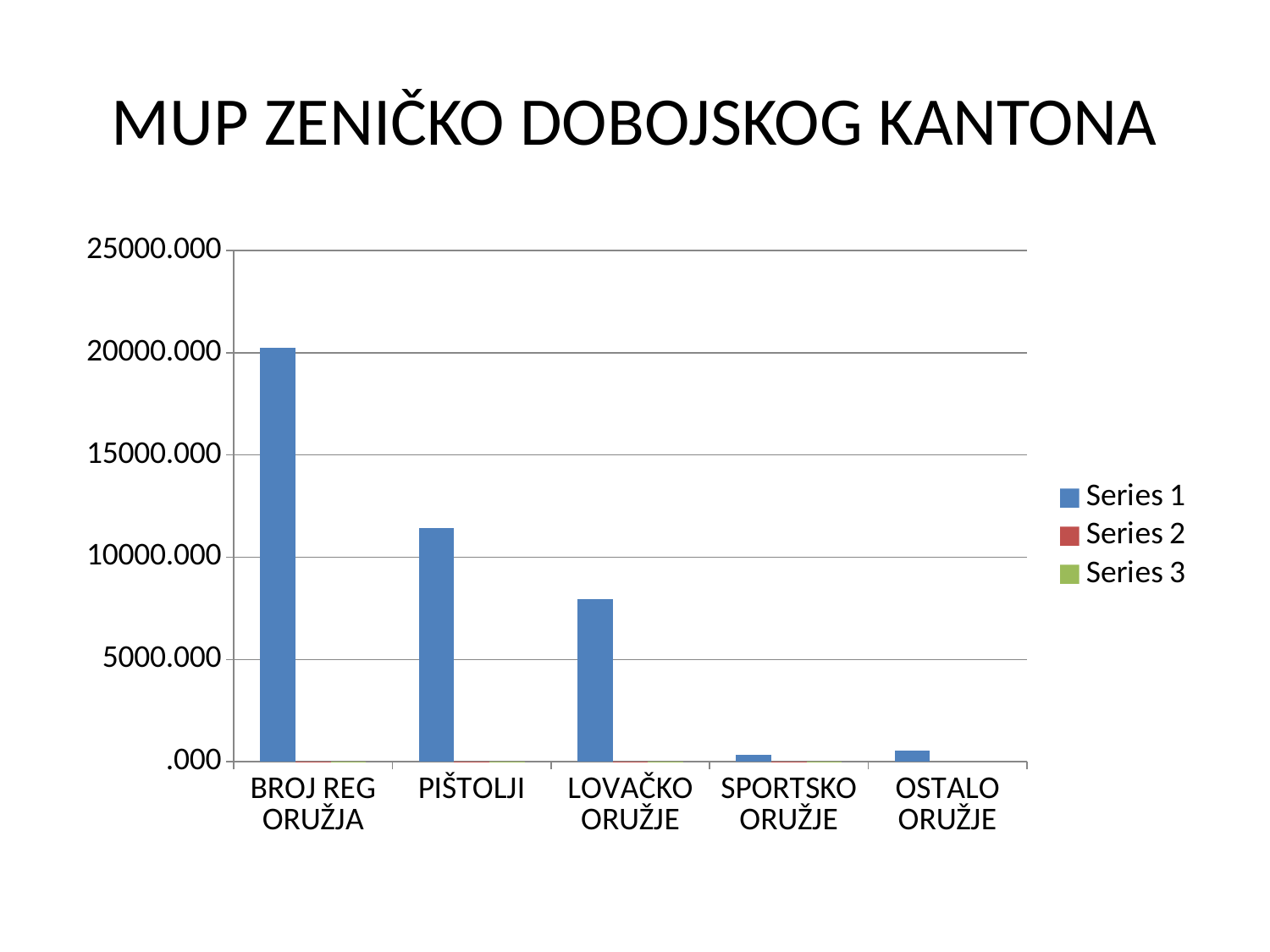
What is the title of the slide? MUP ZENIČKO DOBOJSKOG KANTONA Which category has the highest Series 1 value? BROJ REG ORUŽJA Which has a larger Series 1 value, PIŠTOLJI or LOVAČKO ORUŽJE? PIŠTOLJI What kind of chart is shown on the slide? bar chart Which category has the lowest Series 1 value? SPORTSKO ORUŽJE Is the Series 1 value for BROJ REG ORUŽJA greater or less than 15000.000? greater How many categories are shown on the x axis? 5 How many series does the legend list? 3 Is the Series 1 value for PIŠTOLJI greater or less than 10000.000? greater Is the Series 1 value for LOVAČKO ORUŽJE greater or less than 10000.000? less Which series is shown in blue in the legend? Series 1